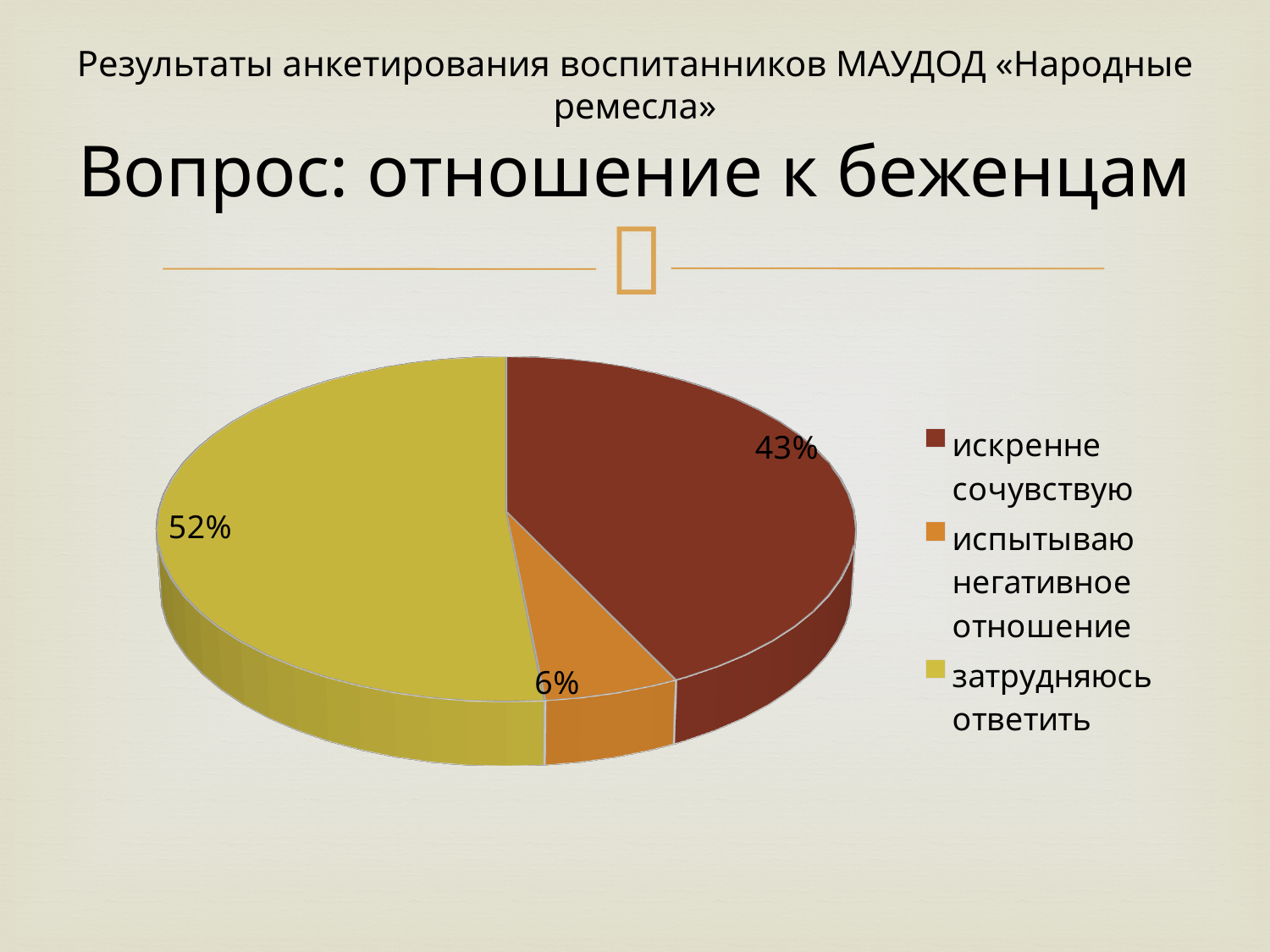
What percentage of respondents answered «затрудняюсь ответить»? 52% What kind of chart is shown on the slide? pie chart What is the difference in percentage points between «искренне сочувствую» and «испытываю негативное отношение»? 37 Which answer option has the smallest share of the pie? испытываю негативное отношение How many slices does the pie chart have? 3 Which is larger: the share for «искренне сочувствую» or the share for «испытываю негативное отношение»? искренне сочувствую What percentage of respondents answered «искренне сочувствую»? 43% What colour is the slice for «затрудняюсь ответить»? yellow Which answer option has the largest share of the pie? затрудняюсь ответить What percentage of respondents answered «испытываю негативное отношение»? 6% What is the difference in percentage points between «затрудняюсь ответить» and «искренне сочувствую»? 9 How many entries does the legend list? 3